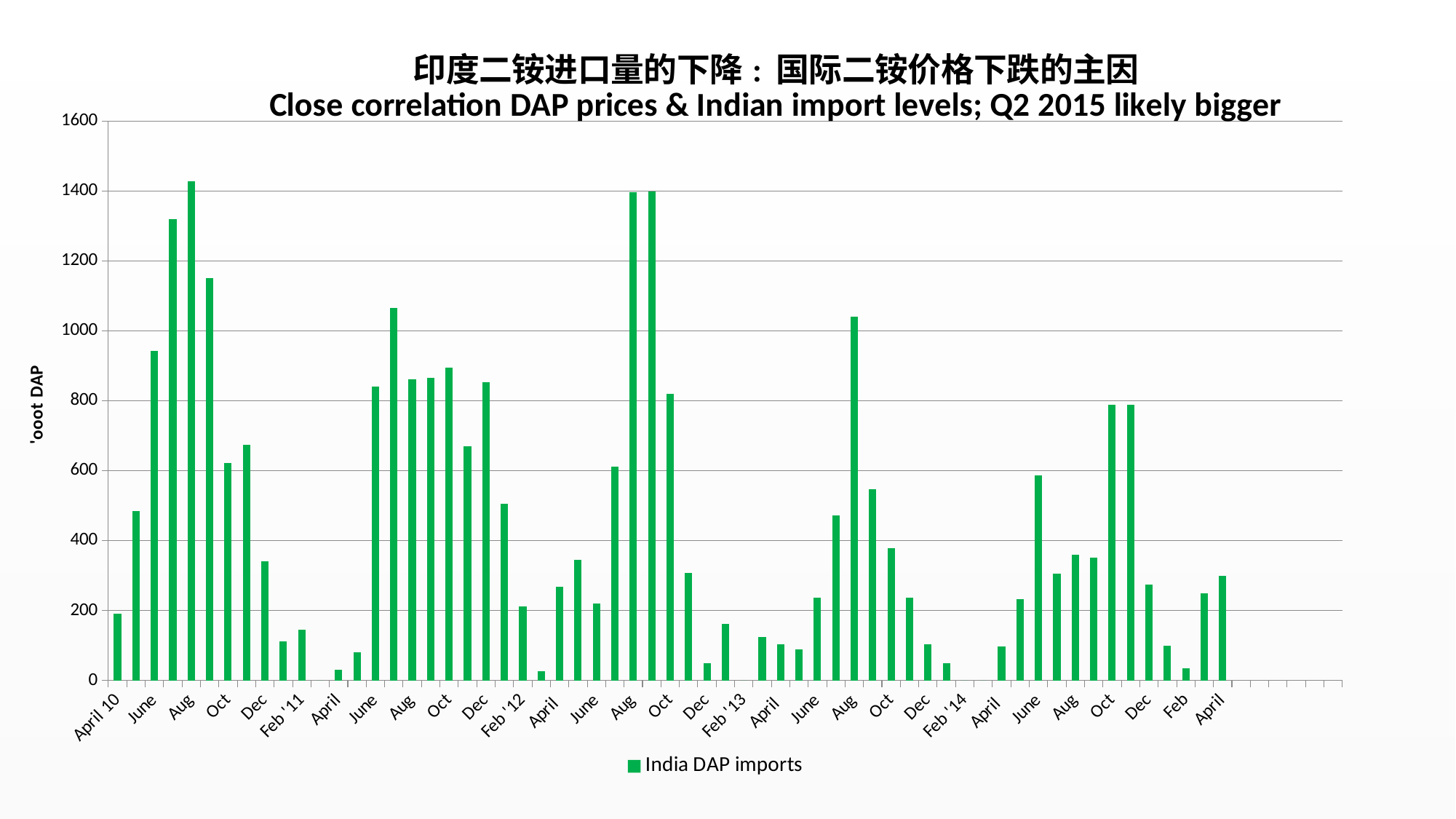
Is the value for Oct 2014 greater or less than 600? greater Which month has the highest India DAP imports? Aug (2010) Is the value for Aug 2012 greater or less than 1200? greater Is the value for Aug 2010 greater or less than 1400? greater What is the name of the series shown in the legend? India DAP imports Which is larger, the value for Aug 2010 or the value for Aug 2011? Aug 2010 What is the label on the vertical axis? 'ooot DAP Which is larger, the value for Oct 2014 or the value for Oct 2013? Oct 2014 How many series does the legend list? 1 What kind of chart is shown on the slide? bar chart